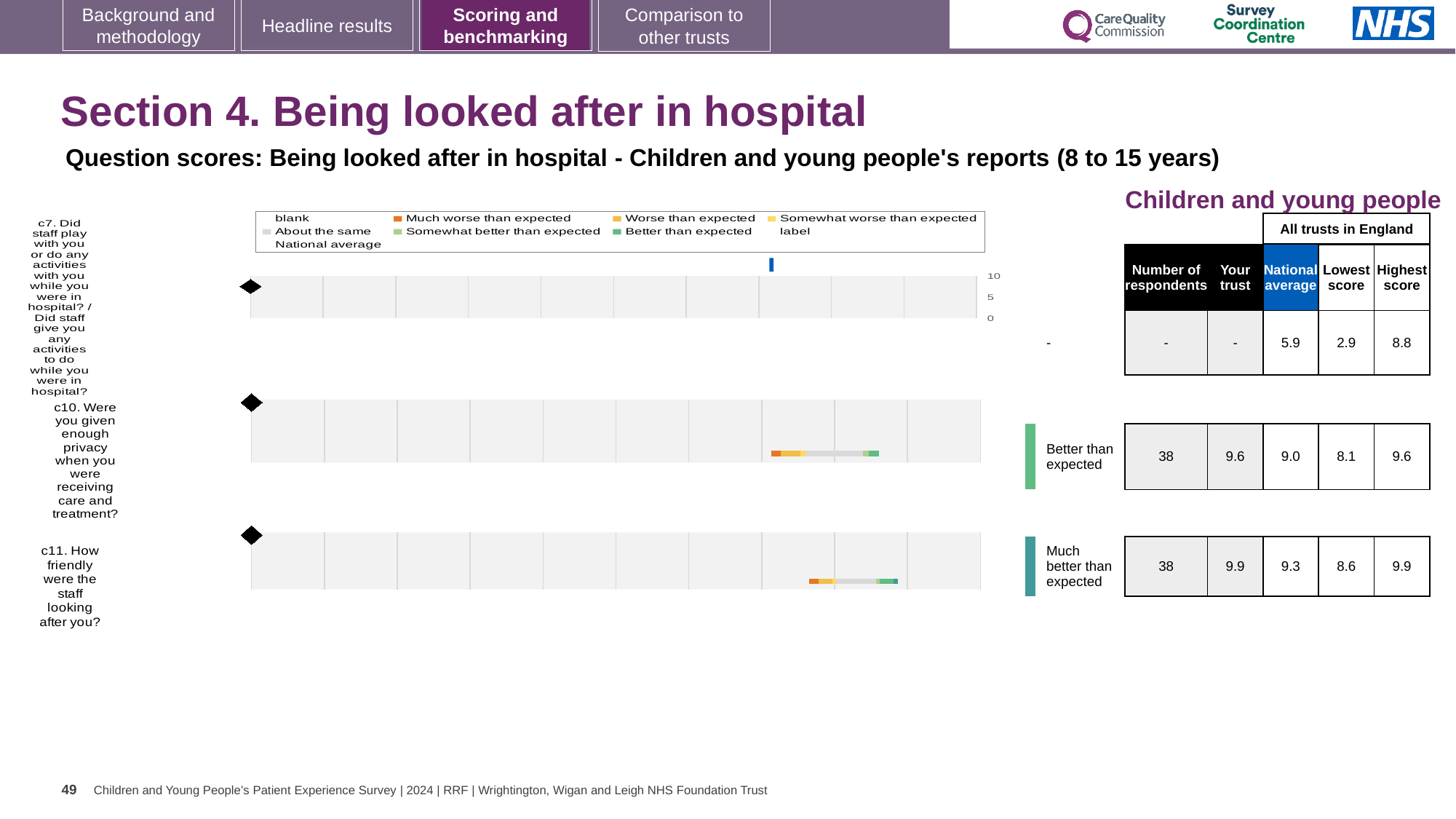
What is the highest score across all trusts in England for c10? 9.6 What is the 'Your trust' score for c10 (Were you given enough privacy when you were receiving care and treatment?)? 9.6 What kind of chart is used to show the question scores on this slide? bar chart By how much does the trust's score for c11 exceed the national average for c11? 0.6 What is the lowest score across all trusts in England for c7? 2.9 How many respondents answered c11? 38 What benchmark category is shown for c10? Better than expected What is the national average score for c11 (How friendly were the staff looking after you?)? 9.3 How many survey questions are plotted on the chart? 3 What is the 'Your trust' score shown for c7? - Which question has the highest national average score? c11 Which question has the higher 'Your trust' score, c10 or c11? c11